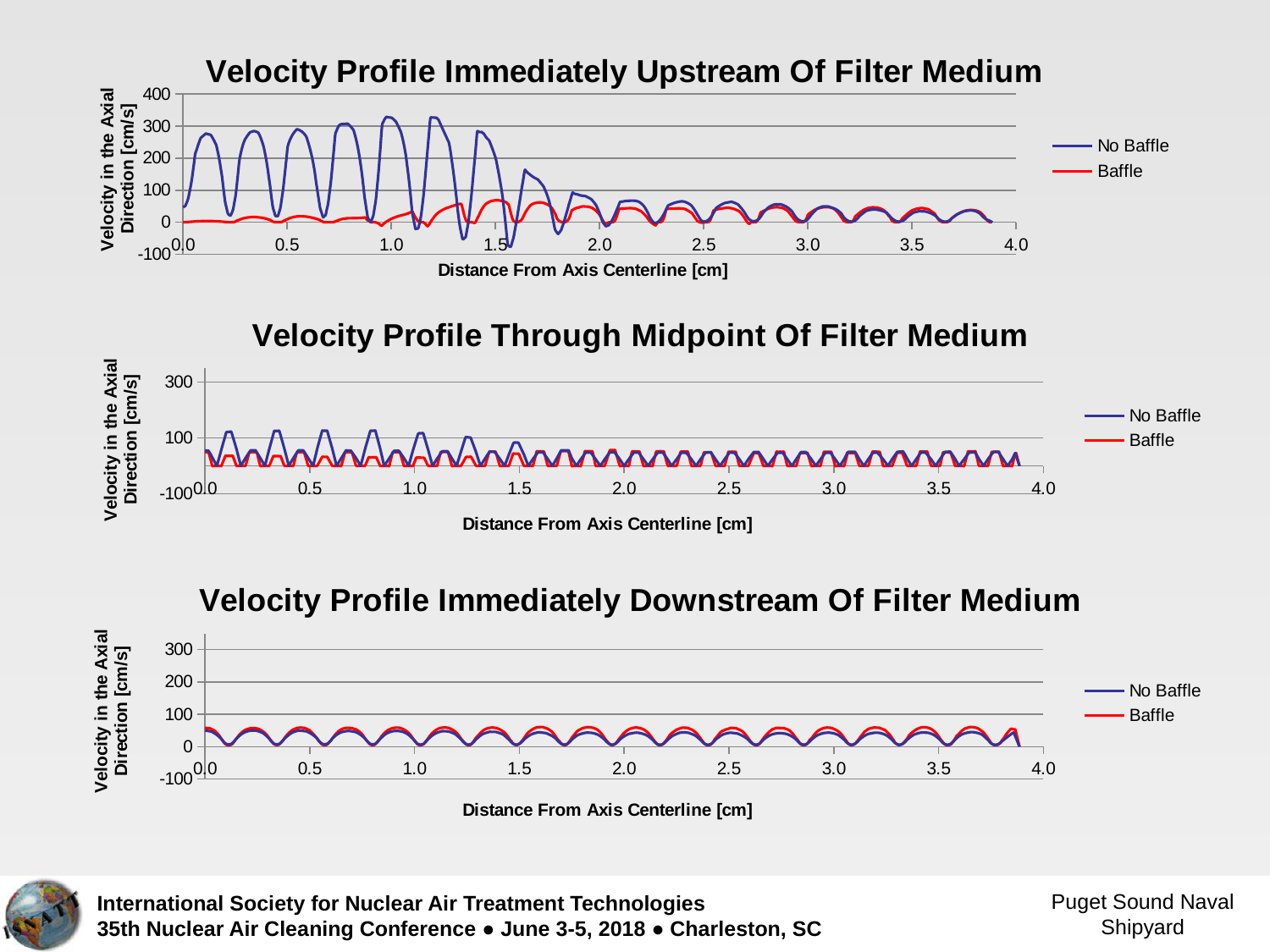
What are the two legend entries in the 'Velocity Profile Immediately Downstream Of Filter Medium' chart? No Baffle and Baffle In the 'Velocity Profile Immediately Upstream Of Filter Medium' chart, which series has the higher peak near 0.5 cm, No Baffle or Baffle? No Baffle In the 'Velocity Profile Immediately Upstream Of Filter Medium' chart, do the No Baffle peaks rise or fall as distance increases from 1.5 cm to 4.0 cm? fall In the 'Velocity Profile Through Midpoint Of Filter Medium' chart, is the first No Baffle peak near 0.1 cm greater or less than 100? greater What is the x-axis label of the 'Velocity Profile Immediately Downstream Of Filter Medium' chart? Distance From Axis Centerline [cm] How many series does the legend of the 'Velocity Profile Through Midpoint Of Filter Medium' chart list? 2 In the 'Velocity Profile Immediately Upstream Of Filter Medium' chart, is the Baffle value at 0.5 cm greater or less than 100? less What kind of chart is the 'Velocity Profile Immediately Upstream Of Filter Medium' chart? line chart In the 'Velocity Profile Through Midpoint Of Filter Medium' chart, is the Baffle value at 2.0 cm greater or less than 100? less How many charts are shown on the slide? 3